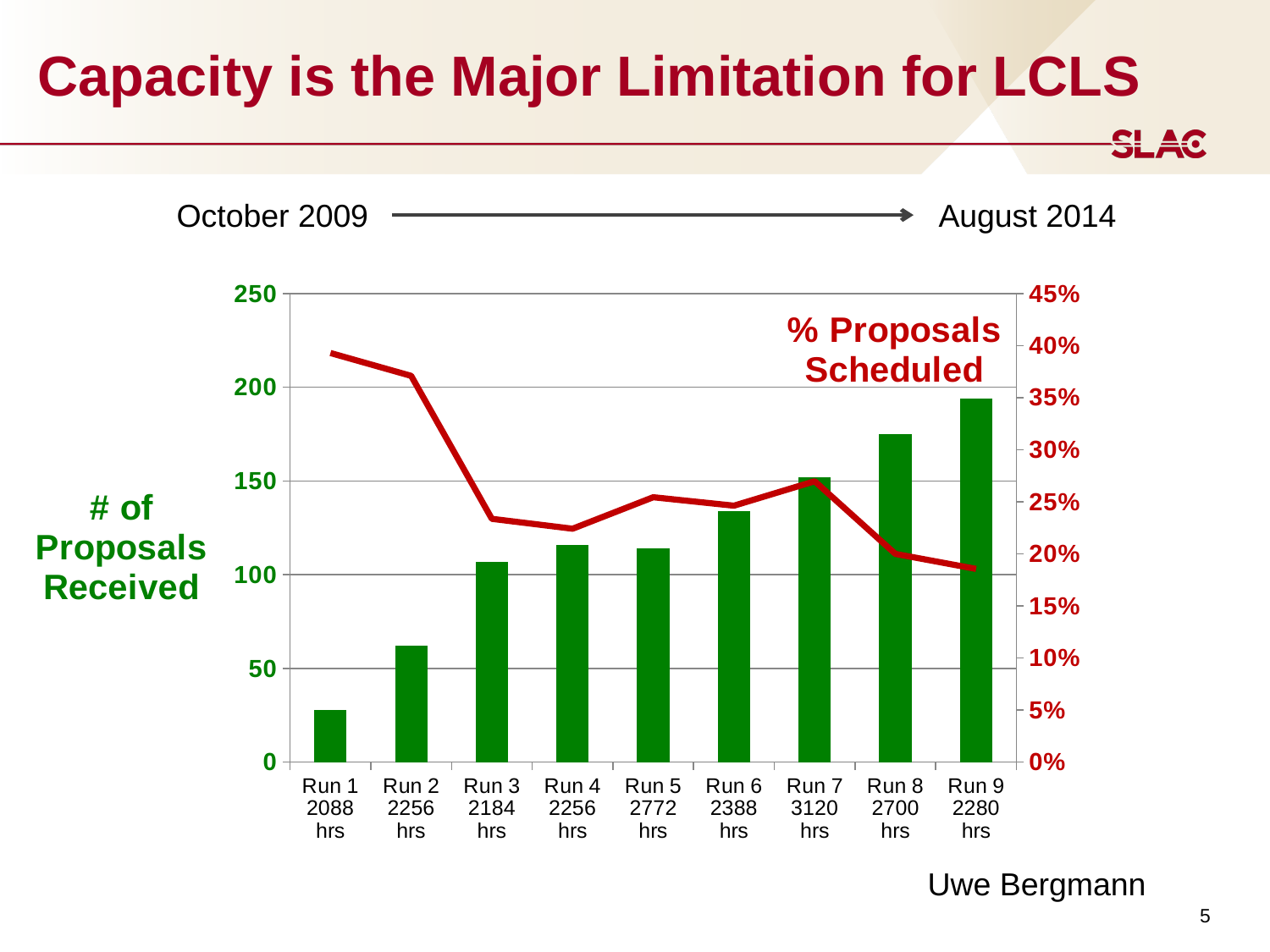
What kind of chart is shown on the slide? bar chart with a line How many hours are listed under Run 7 on the x axis? 3120 hrs Is the number of proposals received for Run 8 greater or less than 150? greater Which run has the lowest number of proposals received? Run 1 Which run has the highest % Proposals Scheduled on the red line? Run 1 Is the number of proposals received for Run 9 greater or less than 150? greater Do the number of proposals received generally rise or fall from Run 1 to Run 9? rise Is the number of proposals received for Run 1 greater or less than 50? less How many runs are shown along the x axis of the chart? 9 Which run has the highest number of proposals received? Run 9 Which run received more proposals, Run 6 or Run 7? Run 7